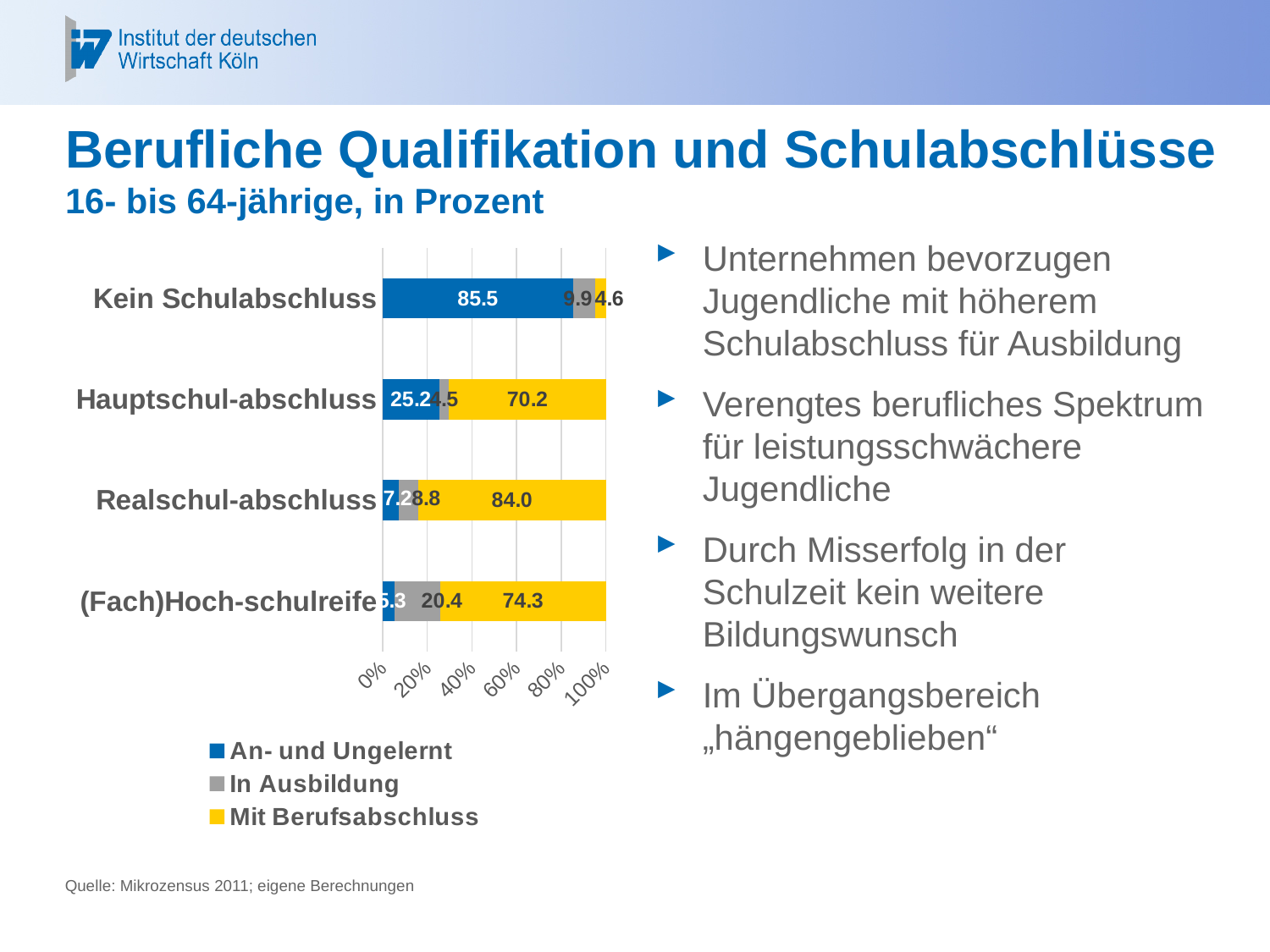
What is the value for 'An- und Ungelernt' in the 'Kein Schulabschluss' category? 85.5 Which category has the highest value for 'Mit Berufsabschluss'? Realschul-abschluss What is the value for 'Mit Berufsabschluss' in the 'Realschul-abschluss' category? 84.0 Which category has the highest value for 'An- und Ungelernt'? Kein Schulabschluss Is the 'An- und Ungelernt' value for 'Hauptschul-abschluss' larger than that for 'Realschul-abschluss'? Yes What is the difference between the 'Mit Berufsabschluss' values for 'Realschul-abschluss' and '(Fach)Hoch-schulreife'? 9.7 Which series is shown in yellow in the legend? Mit Berufsabschluss How many school-leaving categories are shown on the chart? 4 What kind of chart is shown on the slide? Stacked bar chart What is the value for 'In Ausbildung' in the '(Fach)Hoch-schulreife' category? 20.4 How many series does the legend list? 3 What is the value for 'Mit Berufsabschluss' in the 'Hauptschul-abschluss' category? 70.2